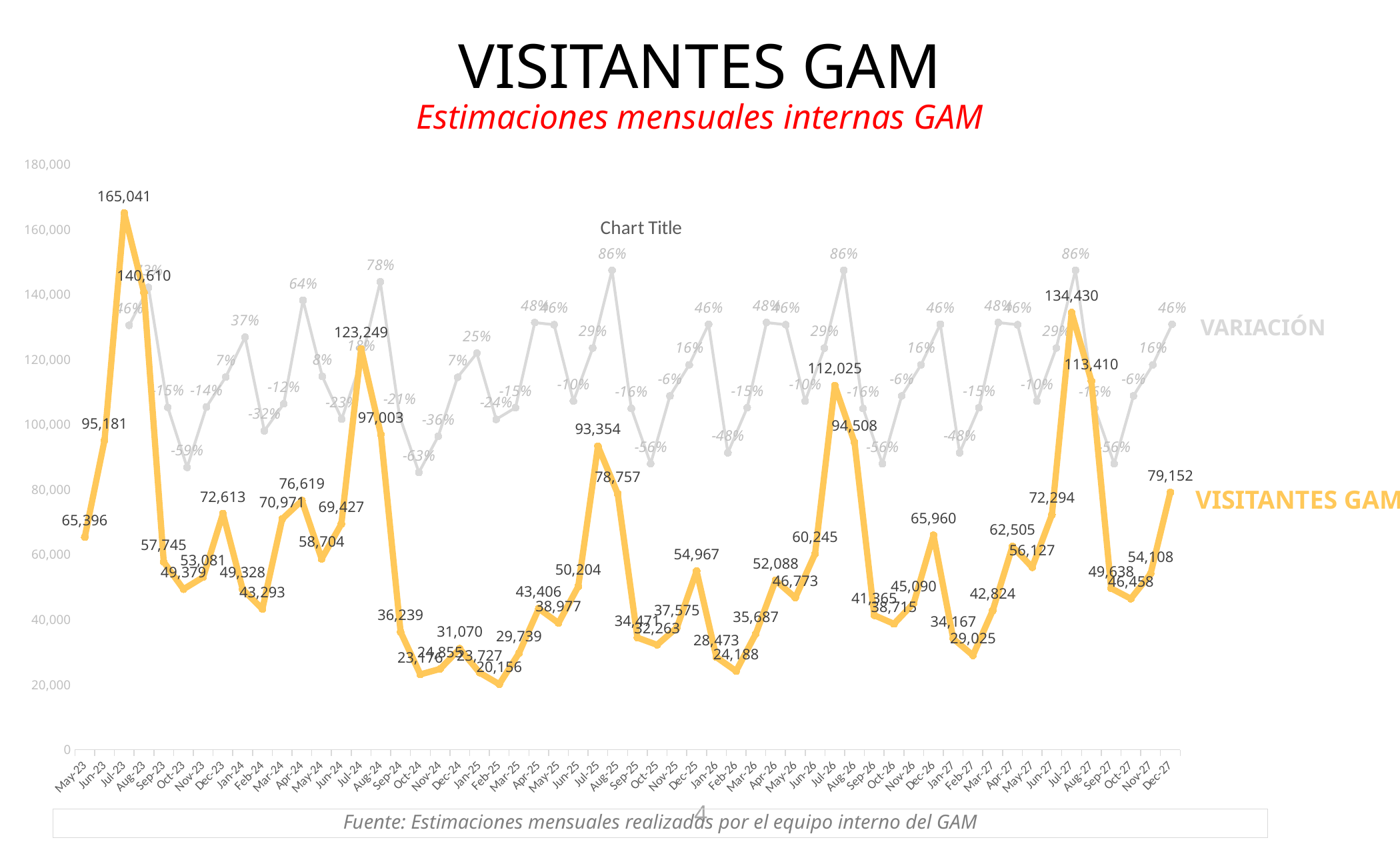
How many series does the chart show? 2 What colour is the VISITANTES GAM line? Yellow What is the difference between the VISITANTES GAM values for Jul-23 and Aug-23? 24,431 Which month has the highest VISITANTES GAM value? Jul-23 What kind of chart is shown on the slide? Line chart What is the VISITANTES GAM value for Jul-26? 112,025 What is the VISITANTES GAM value for Dec-27? 79,152 Is the VISITANTES GAM value for Jul-27 greater or less than 120,000? greater What is the VARIACIÓN value for Jul-25? 86% Which month has the lowest VISITANTES GAM value? Feb-25 What is the VISITANTES GAM value for Jul-23? 165,041 Which is larger, the VISITANTES GAM value for Jul-24 or for Jul-27? Jul-27